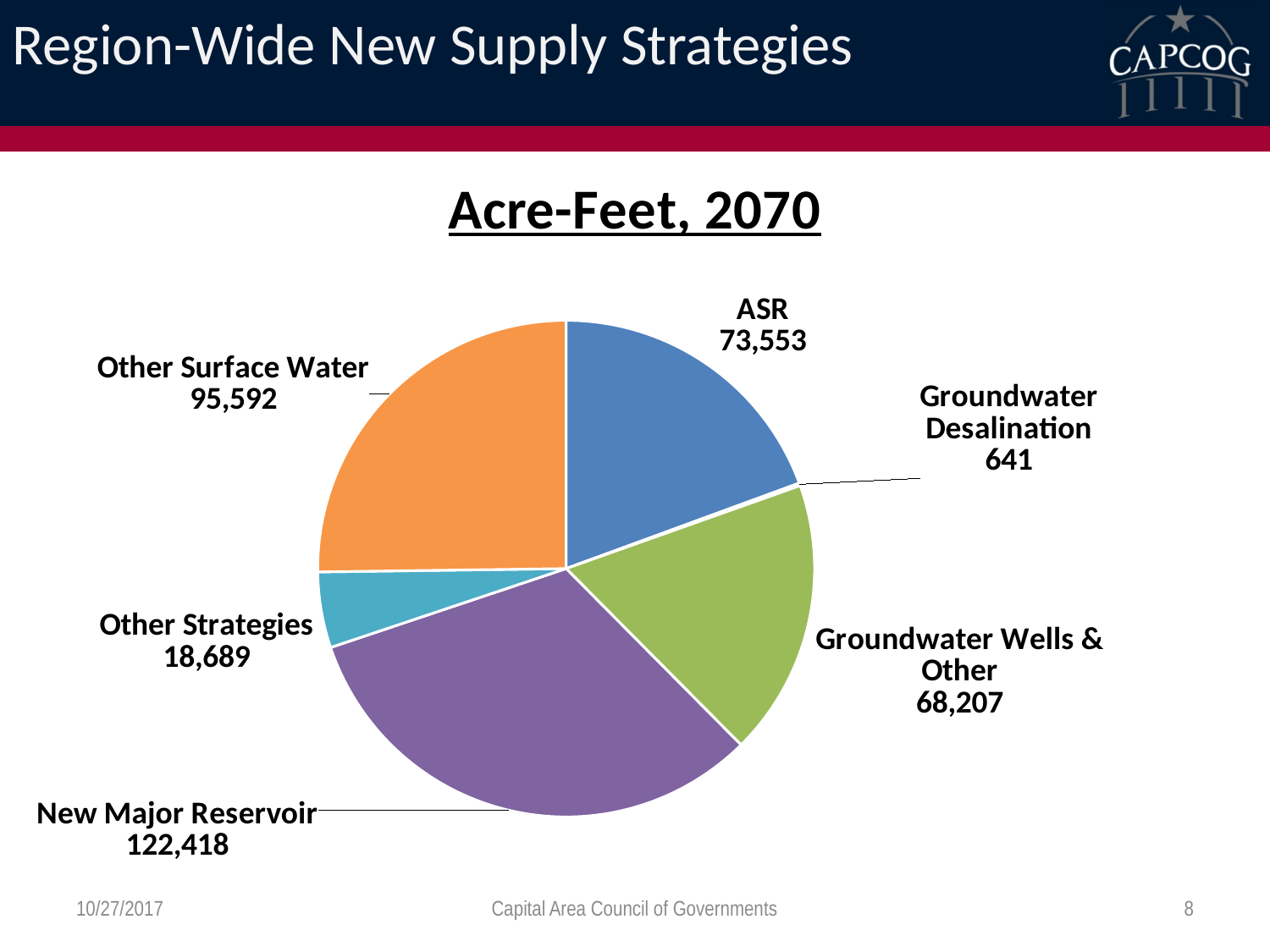
How many slices does the pie chart have? 6 Which is larger, ASR or Groundwater Wells & Other? ASR What is the difference between New Major Reservoir and Other Surface Water? 26,826 What is the value for Groundwater Desalination? 641 What type of chart is shown on the slide? Pie chart Which category has the smallest slice? Groundwater Desalination Which category has the largest slice? New Major Reservoir What is the value for Other Surface Water? 95,592 What is the value for New Major Reservoir? 122,418 What is the title of the chart? Acre-Feet, 2070 What colour is the New Major Reservoir slice? Purple What is the difference between Other Surface Water and Other Strategies? 76,903